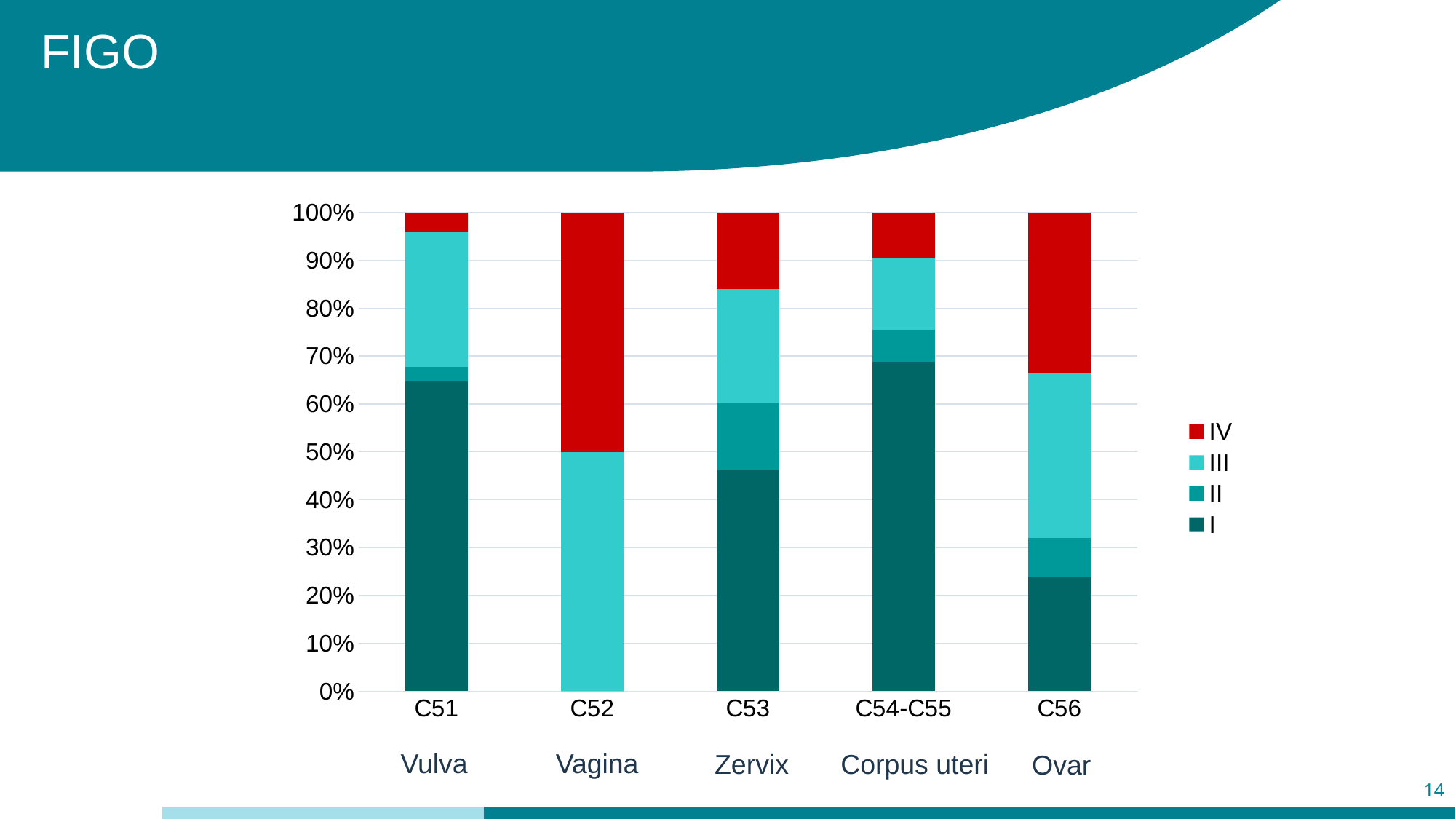
Which has the larger stage III share, C53 or C56? C56 What is the title of the slide containing the chart? FIGO Is the stage I share for C56 greater or less than 30%? less Is the stage I share for C53 greater or less than 50%? less Which category has no stage I segment at all? C52 What kind of chart is shown on the slide? stacked bar chart Is the stage I share for C51 greater or less than 60%? greater Which has the larger stage IV share, C51 or C52? C52 How many series does the legend list? 4 Which category has the largest share for stage IV? C52 How many categories are shown on the x axis of the chart? 5